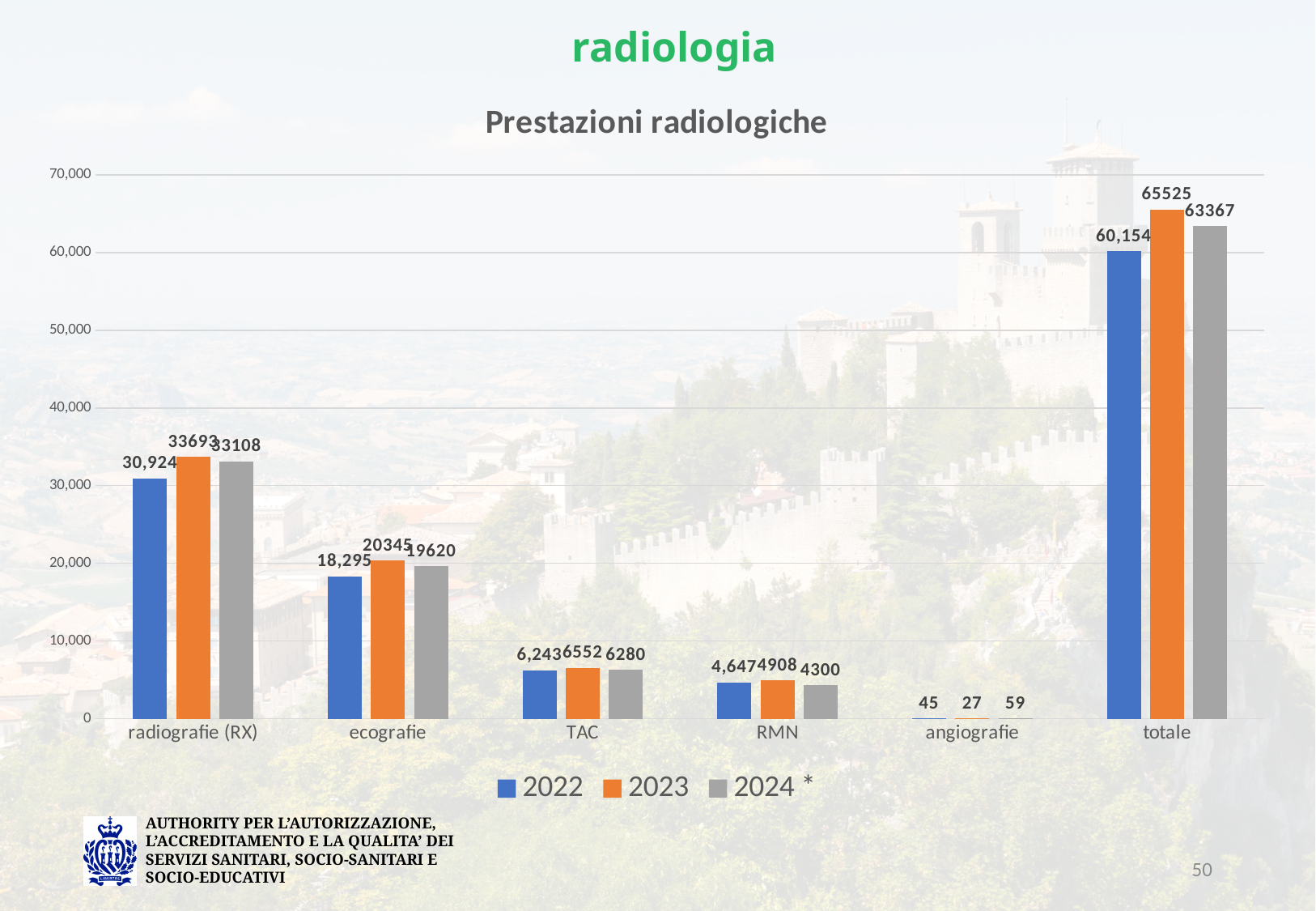
What is the value for ecografie in 2023? 20345 What is the difference between the totale values for 2023 and 2024? 2158 What is the title of the chart? Prestazioni radiologiche Excluding totale, which category has the highest value in 2024? radiografie (RX) What is the value for totale in 2022? 60,154 How many series does the legend list? 3 What is the value for angiografie in 2024? 59 What type of chart is shown on the slide? bar chart Which category has the lowest value in 2022? angiografie How many categories are shown on the x axis? 6 What is the value for RMN in 2023? 4908 Which is larger, the TAC value for 2023 or for 2024? 2023